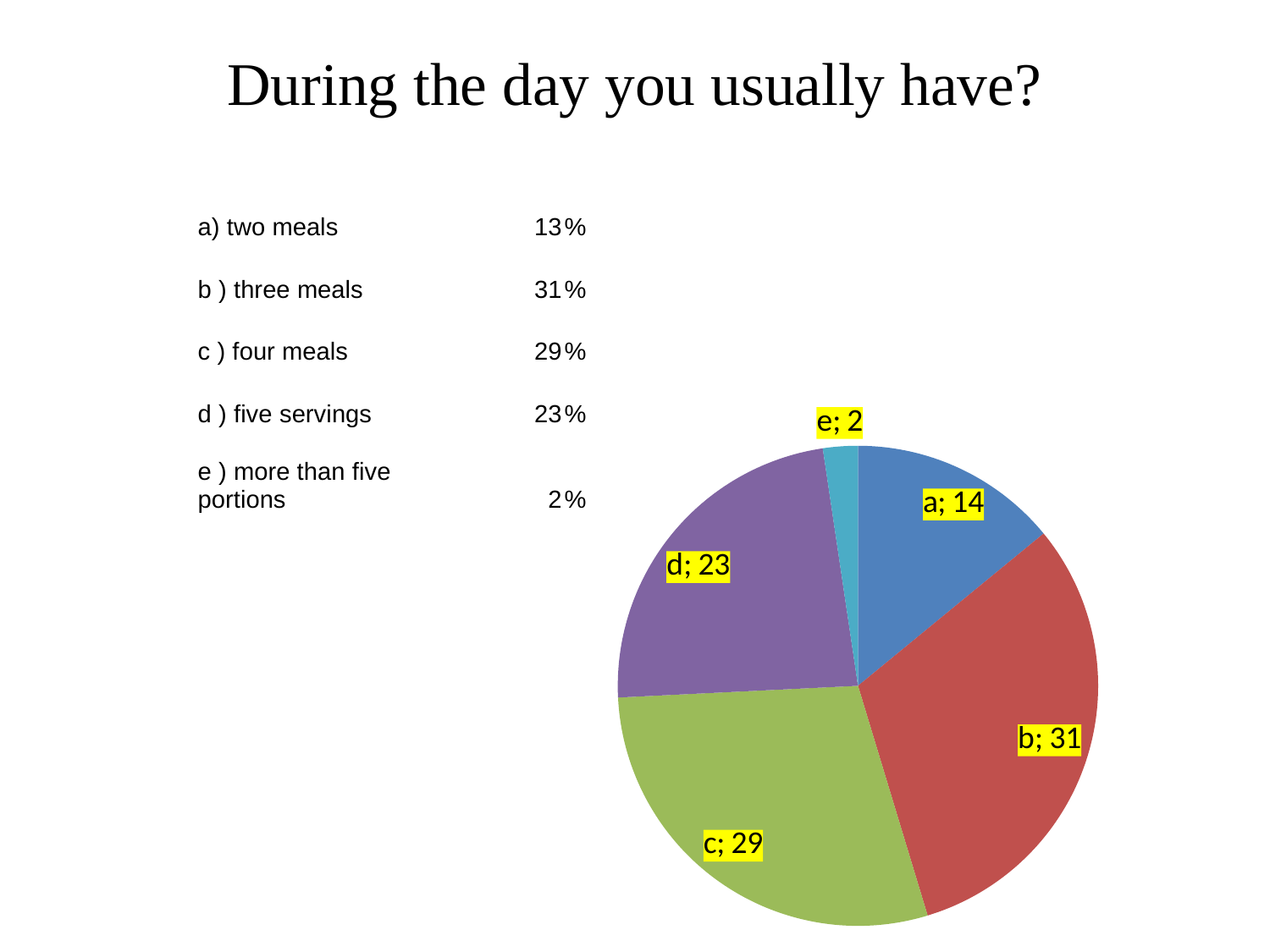
What value is labelled on the pie slice for b? 31 What value is labelled on the pie slice for d? 23 What kind of chart is shown on the slide? pie chart Which slice of the pie chart has the smallest value? e What is the difference between the labelled values of slices c and e in the pie chart? 27 In the pie chart, which slice has the larger labelled value, a or d? d How many slices does the pie chart have? 5 Which slice of the pie chart has the largest value? b What value is labelled on the pie slice for e? 2 What is the difference between the labelled values of slices b and d in the pie chart? 8 What value is labelled on the pie slice for c? 29 What colour is the slice labelled b in the pie chart? red